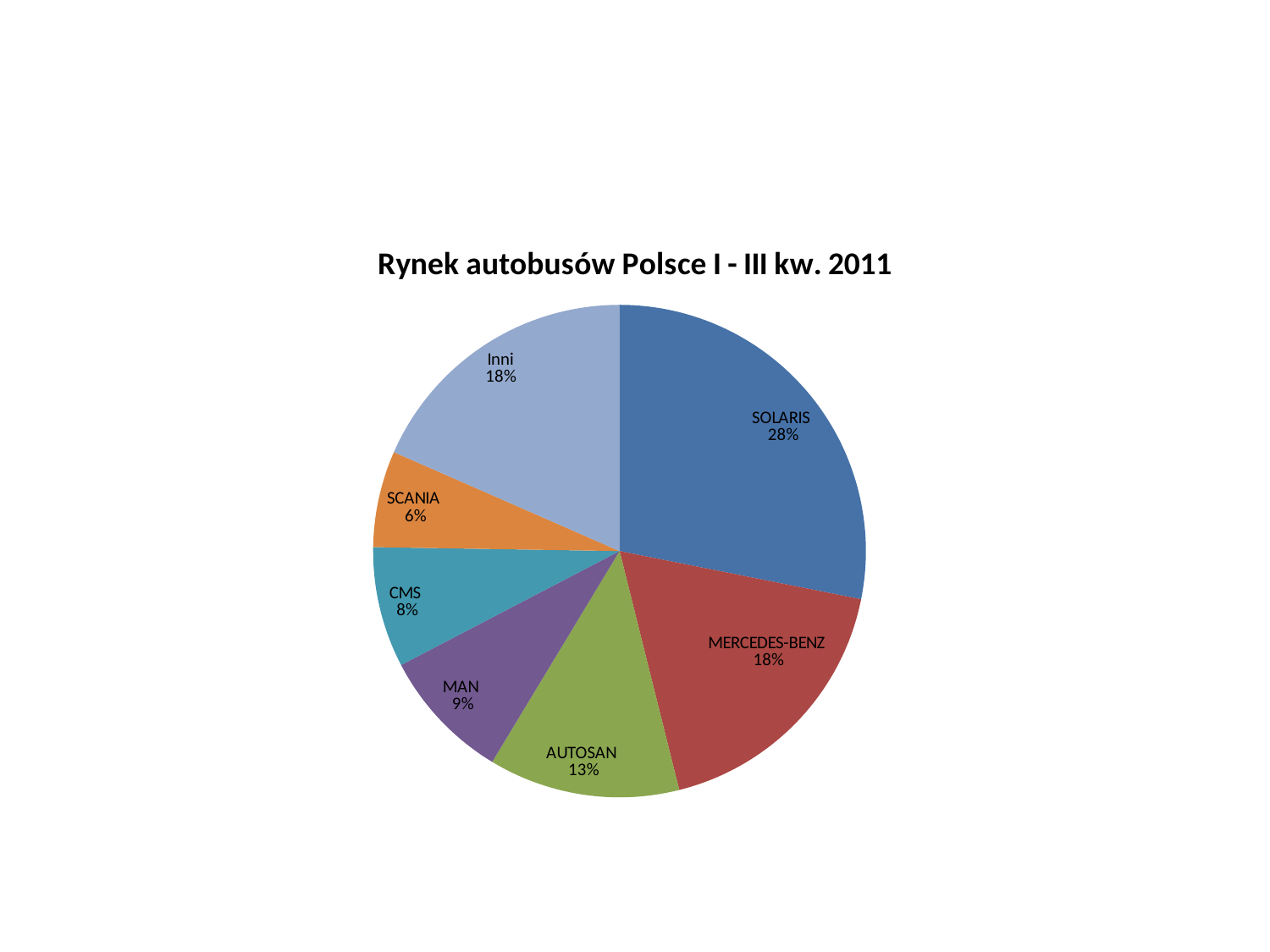
What is the title of the chart? Rynek autobusów Polsce I - III kw. 2011 What kind of chart is shown on the slide? Pie chart What is the value shown for AUTOSAN? 13% What is the value shown for SCANIA? 6% Which is larger, the share for MAN or the share for CMS? MAN Which category has the largest slice of the pie? SOLARIS What is the difference in percentage points between AUTOSAN and MAN? 4 What is the value shown for MERCEDES-BENZ? 18% Which category has the smallest slice of the pie? SCANIA What share of the pie does SOLARIS hold? 28% What is the difference in percentage points between SOLARIS and MERCEDES-BENZ? 10 How many slices does the pie chart have? 7